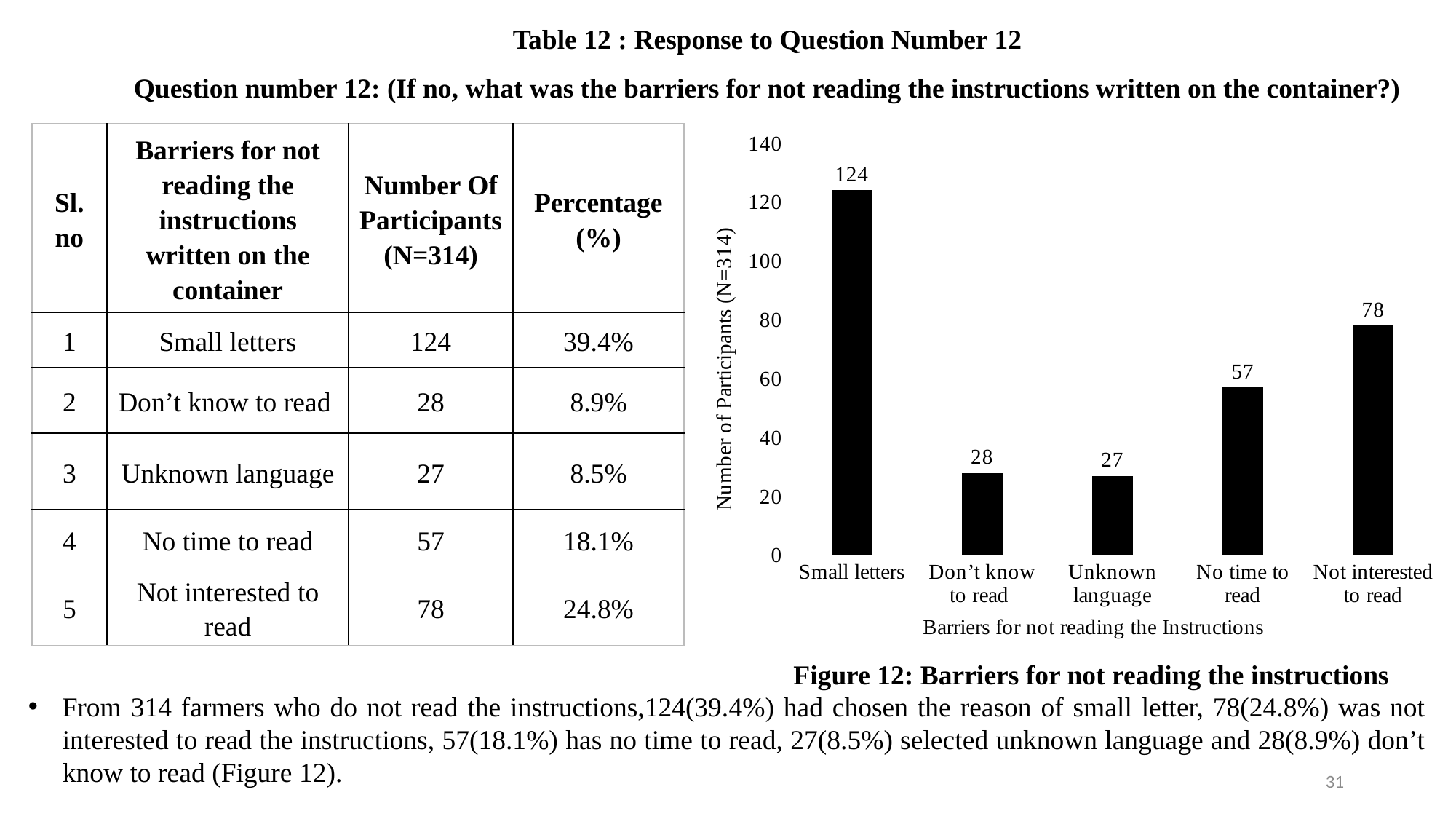
Which has more participants, No time to read or Not interested to read? Not interested to read What is the label of the chart's x axis? Barriers for not reading the Instructions What is the number of participants for Not interested to read in the chart? 78 What is the difference in number of participants between No time to read and Don't know to read? 29 Is the value for Small letters greater or less than 100? greater How many barrier categories are shown in the chart? 5 Which barrier has the lowest number of participants in the chart? Unknown language What kind of chart is shown on the slide? Bar chart What is the number of participants for Small letters in the chart? 124 What is the number of participants for No time to read in the chart? 57 Which barrier has the highest number of participants in the chart? Small letters What is the difference in number of participants between Small letters and Not interested to read? 46